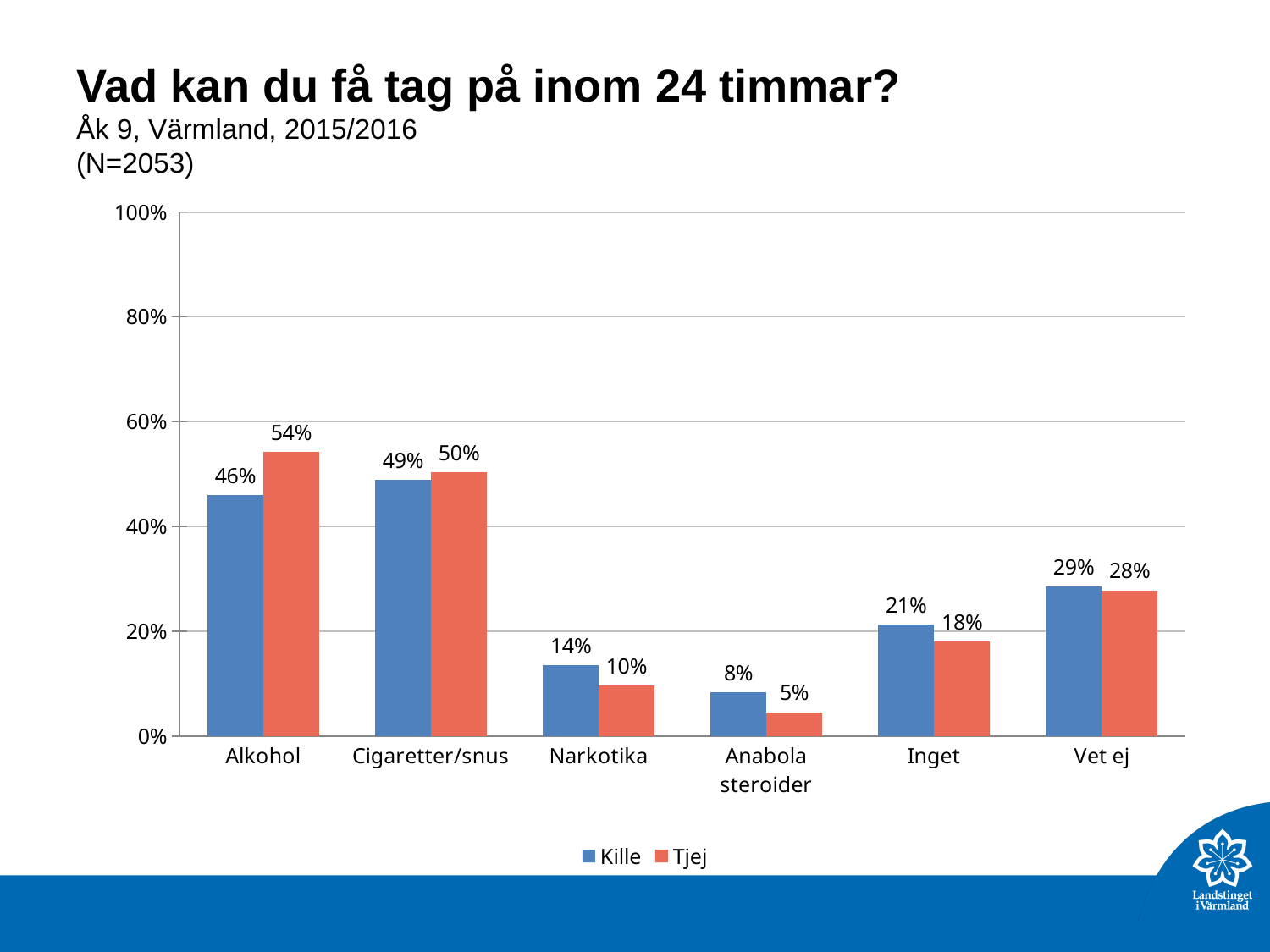
Which category has the lowest value for Kille? Anabola steroider What kind of chart is shown on the slide? Bar chart What is the value for Kille for Alkohol? 46% What is the value for Tjej for Inget? 18% How many categories are shown on the x axis? 6 What is the title of the chart on the slide? Vad kan du få tag på inom 24 timmar? How many series does the legend list? 2 What is the value for Tjej for Narkotika? 10% Which is larger for Inget, the Kille value or the Tjej value? Kille Which category has the highest value for Tjej? Alkohol Is the value for Kille for Cigaretter/snus greater or less than 40%? greater What is the difference between the Tjej and Kille values for Alkohol? 8%